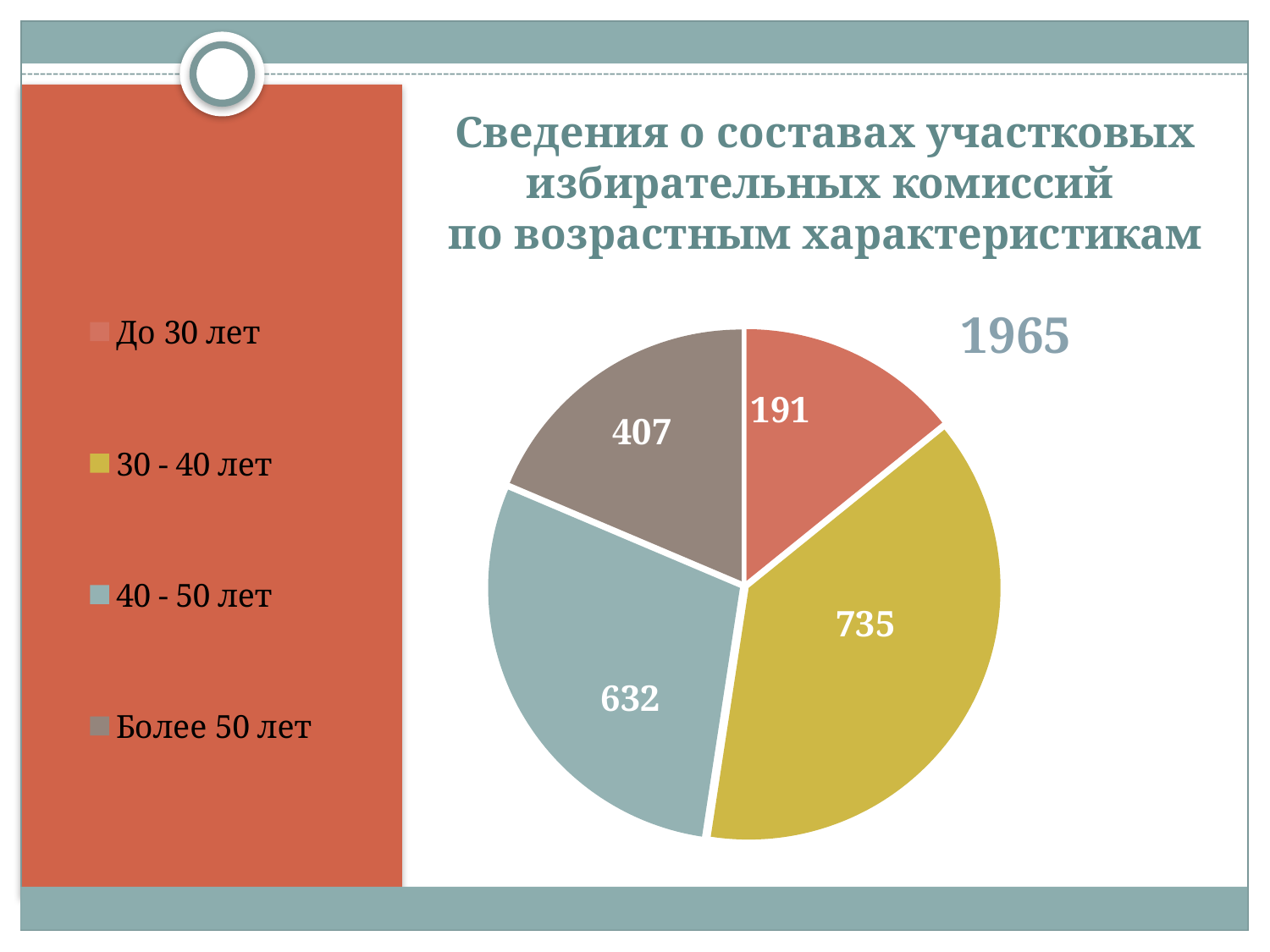
What is the value for the "30 - 40 лет" slice? 735 What type of chart is shown on the slide? Pie chart Which age group has the smallest slice of the pie? До 30 лет What is the total of all slices in the pie chart? 1965 What is the difference between the values for "30 - 40 лет" and "40 - 50 лет"? 103 What colour is the slice for "40 - 50 лет"? Teal (grey-blue) What is the value for the "До 30 лет" slice? 191 Which age group has the largest slice of the pie? 30 - 40 лет Which is larger, the value for "Более 50 лет" or the value for "До 30 лет"? Более 50 лет What is the value for the "40 - 50 лет" slice? 632 What is the value for the "Более 50 лет" slice? 407 How many slices does the pie chart have? 4